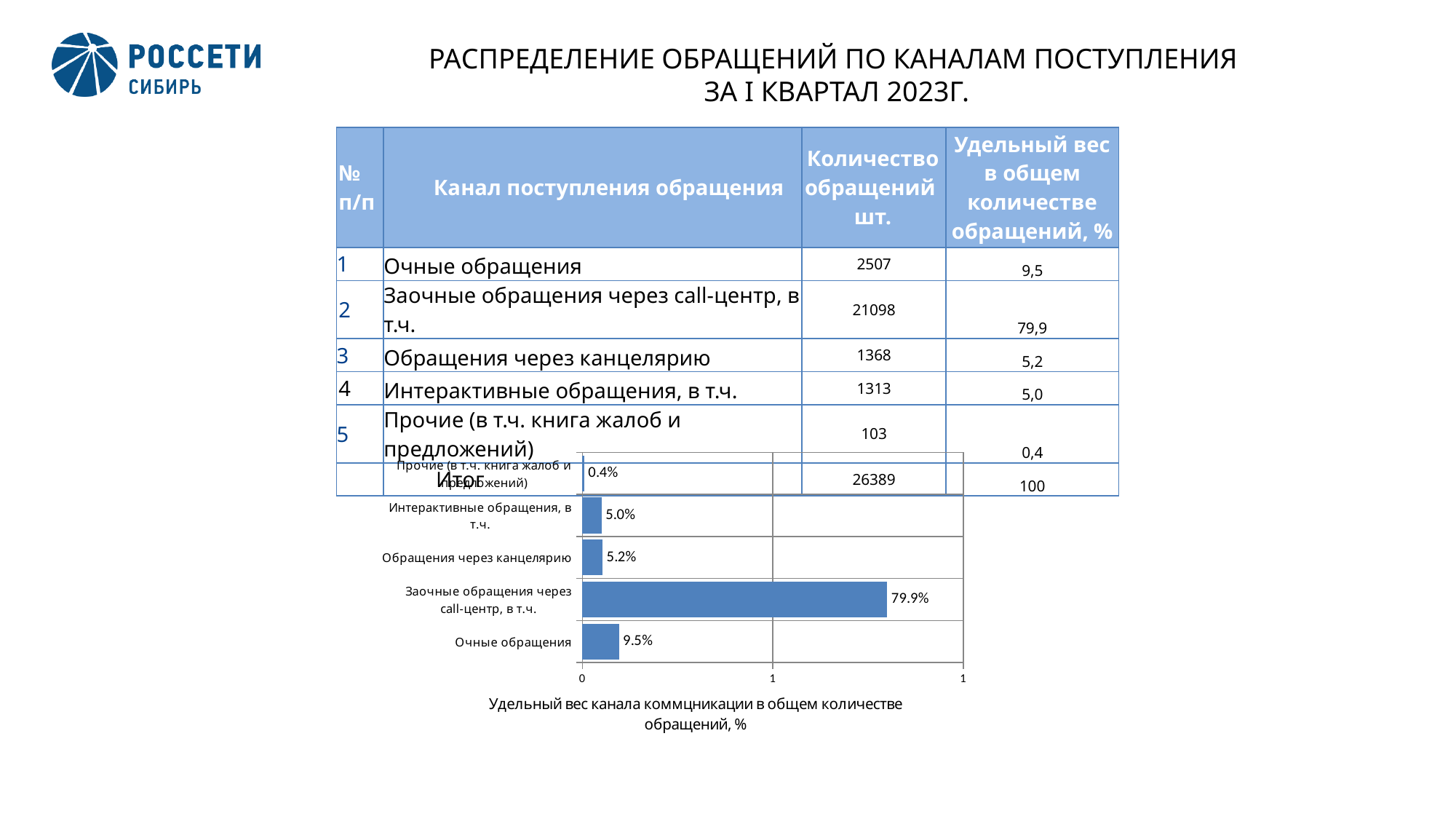
What is the value shown for "Очные обращения" in the bar chart? 9.5% What is the value shown for "Интерактивные обращения, в т.ч." in the bar chart? 5.0% What kind of chart is shown on the slide? bar chart Which category has the highest value in the bar chart? Заочные обращения через call-центр, в т.ч. What is the value shown for "Заочные обращения через call-центр, в т.ч." in the bar chart? 79.9% What is the value shown for "Обращения через канцелярию" in the bar chart? 5.2% How many categories does the bar chart show? 5 What is the title printed below the bar chart? Удельный вес канала коммцникации в общем количестве обращений, % What is the value shown for "Прочие (в т.ч. книга жалоб и предложений)" in the bar chart? 0.4% Which is larger in the bar chart: the value for "Очные обращения" or the value for "Обращения через канцелярию"? Очные обращения What is the difference between the values for "Заочные обращения через call-центр, в т.ч." and "Очные обращения" in the bar chart? 70.4% Which category has the lowest value in the bar chart? Прочие (в т.ч. книга жалоб и предложений)